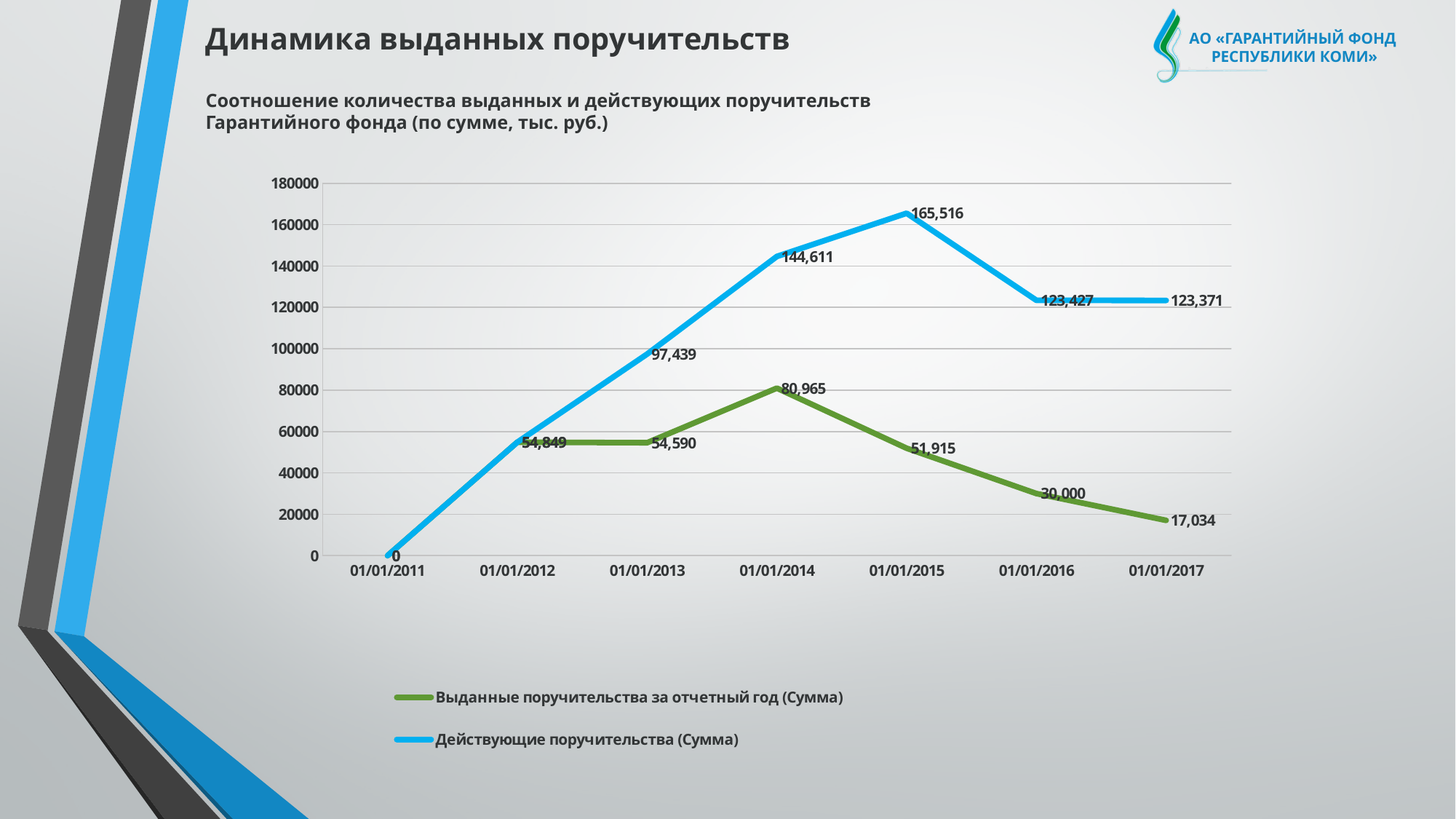
What is the difference between Действующие поручительства (Сумма) at 01/01/2015 and at 01/01/2016? 42,089 How many dates are shown on the x axis? 7 What kind of chart is shown on the slide? Line chart What is the difference between Выданные поручительства за отчетный год (Сумма) at 01/01/2016 and at 01/01/2017? 12,966 What is the value of Выданные поручительства за отчетный год (Сумма) at 01/01/2014? 80,965 What is the value of Действующие поручительства (Сумма) at 01/01/2017? 123,371 At 01/01/2014, which series has the larger value: Выданные поручительства за отчетный год (Сумма) or Действующие поручительства (Сумма)? Действующие поручительства (Сумма) Does Выданные поручительства за отчетный год (Сумма) rise or fall from 01/01/2014 to 01/01/2017? Fall What is the value of Действующие поручительства (Сумма) at 01/01/2015? 165,516 At which date does Действующие поручительства (Сумма) reach its highest value? 01/01/2015 How many series does the legend list? 2 At which date is Выданные поручительства за отчетный год (Сумма) lowest? 01/01/2011